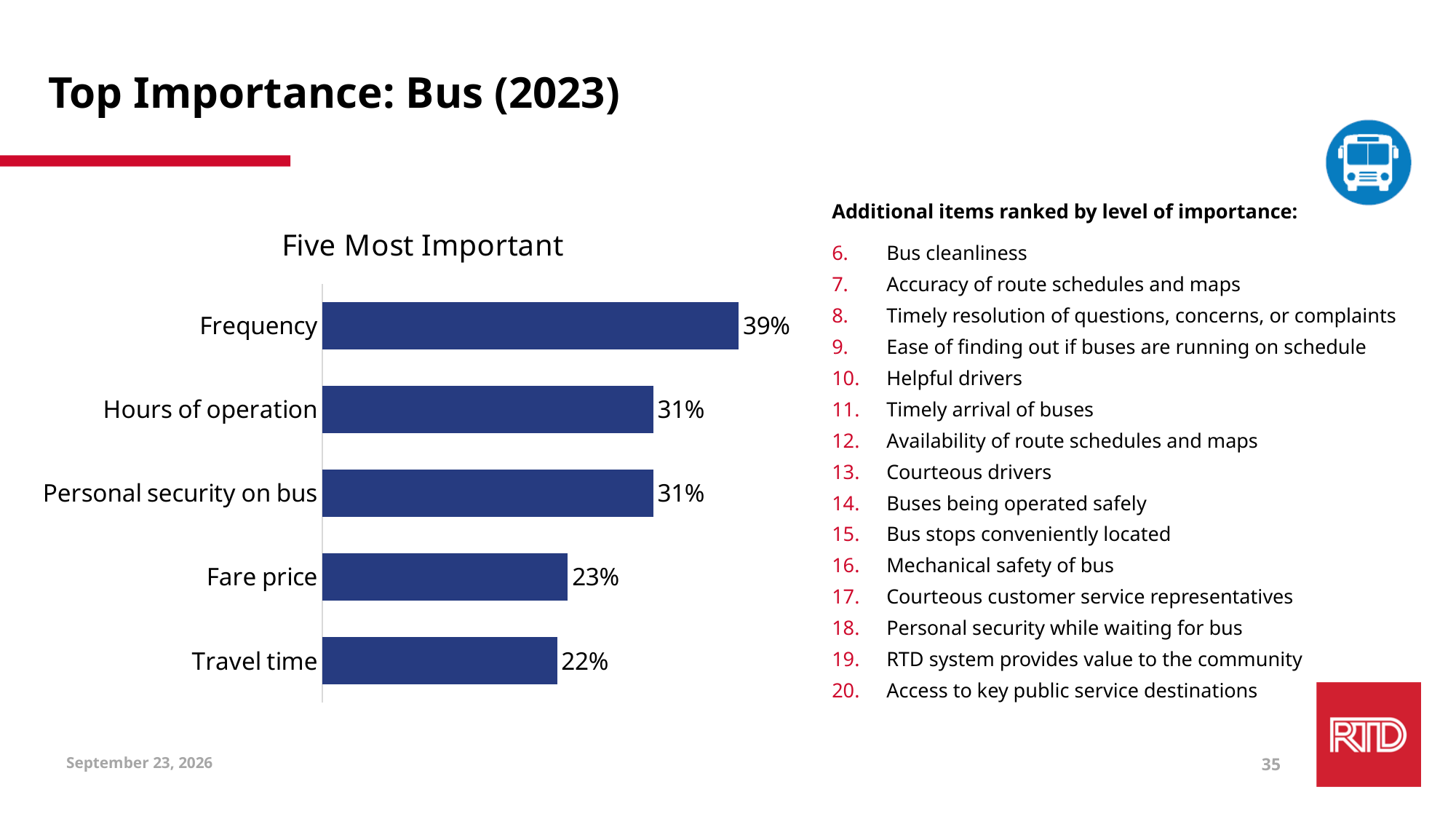
What is the value for Frequency? 39% What is the difference between the values for Fare price and Travel time? 1% What is the value for Personal security on bus? 31% Which category has the lowest value? Travel time What is the difference between the values for Frequency and Hours of operation? 8% What is the value for Travel time? 22% Which category has the highest value? Frequency Which is larger, the value for Hours of operation or the value for Fare price? Hours of operation What is the title of the chart? Five Most Important How many categories are shown in the chart? 5 What kind of chart is shown on the slide? Bar chart What is the value for Fare price? 23%